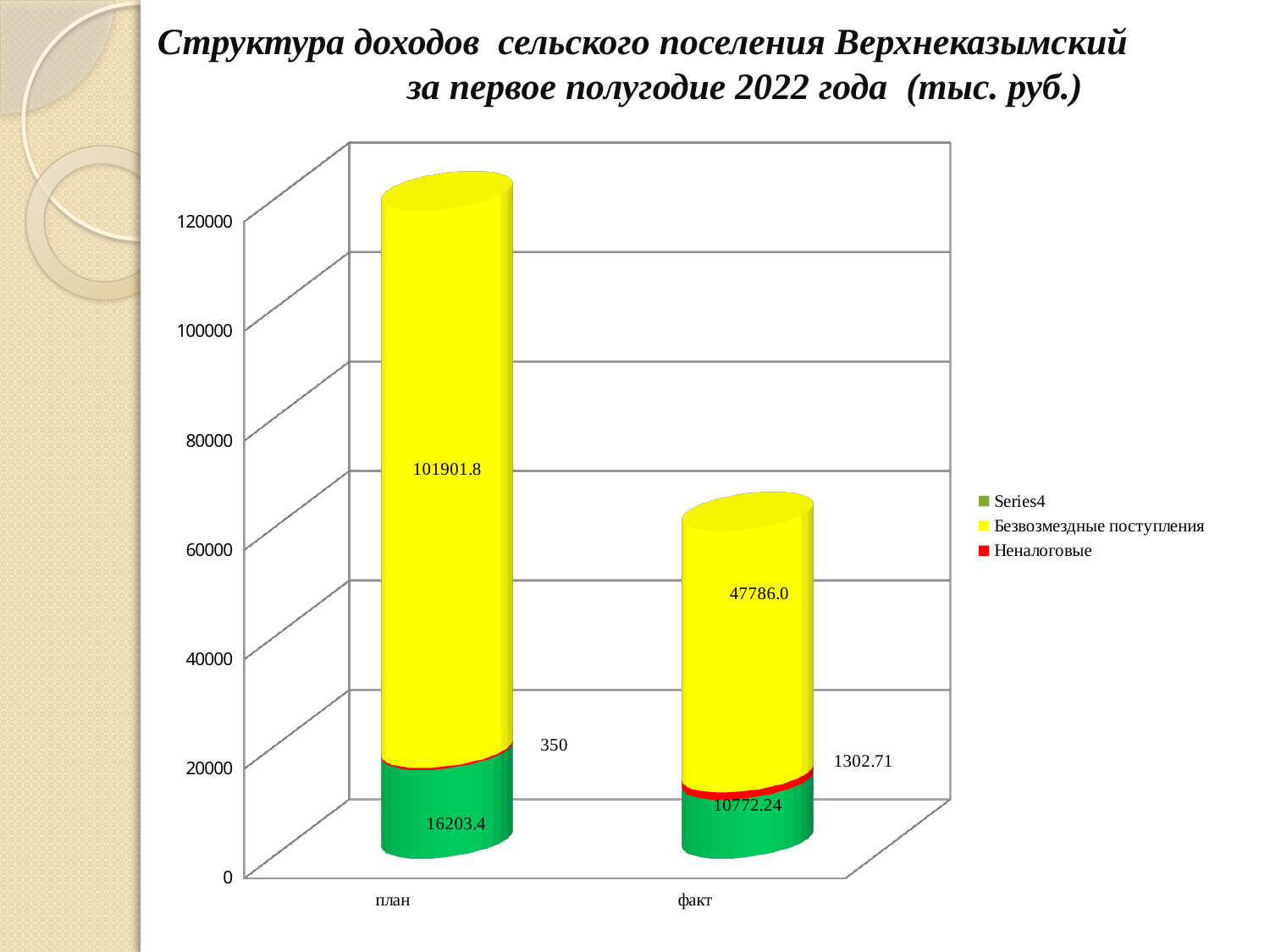
What kind of chart is shown on the slide? Stacked bar chart What is the value of Неналоговые for план? 350 What is the value of Неналоговые for факт? 1302.71 What is the total of the stacked bar for факт? 59860.95 What is the value of Безвозмездные поступления for факт? 47786.0 What is the difference between the Безвозмездные поступления values for план and факт? 54115.8 How many series does the legend list? 3 What is the difference between the Series4 values for план and факт? 5431.16 What is the value of Безвозмездные поступления for план? 101901.8 What is the total of the stacked bar for план? 118455.2 Which category has the higher value for Безвозмездные поступления, план or факт? план What is the value of Series4 for факт? 10772.24